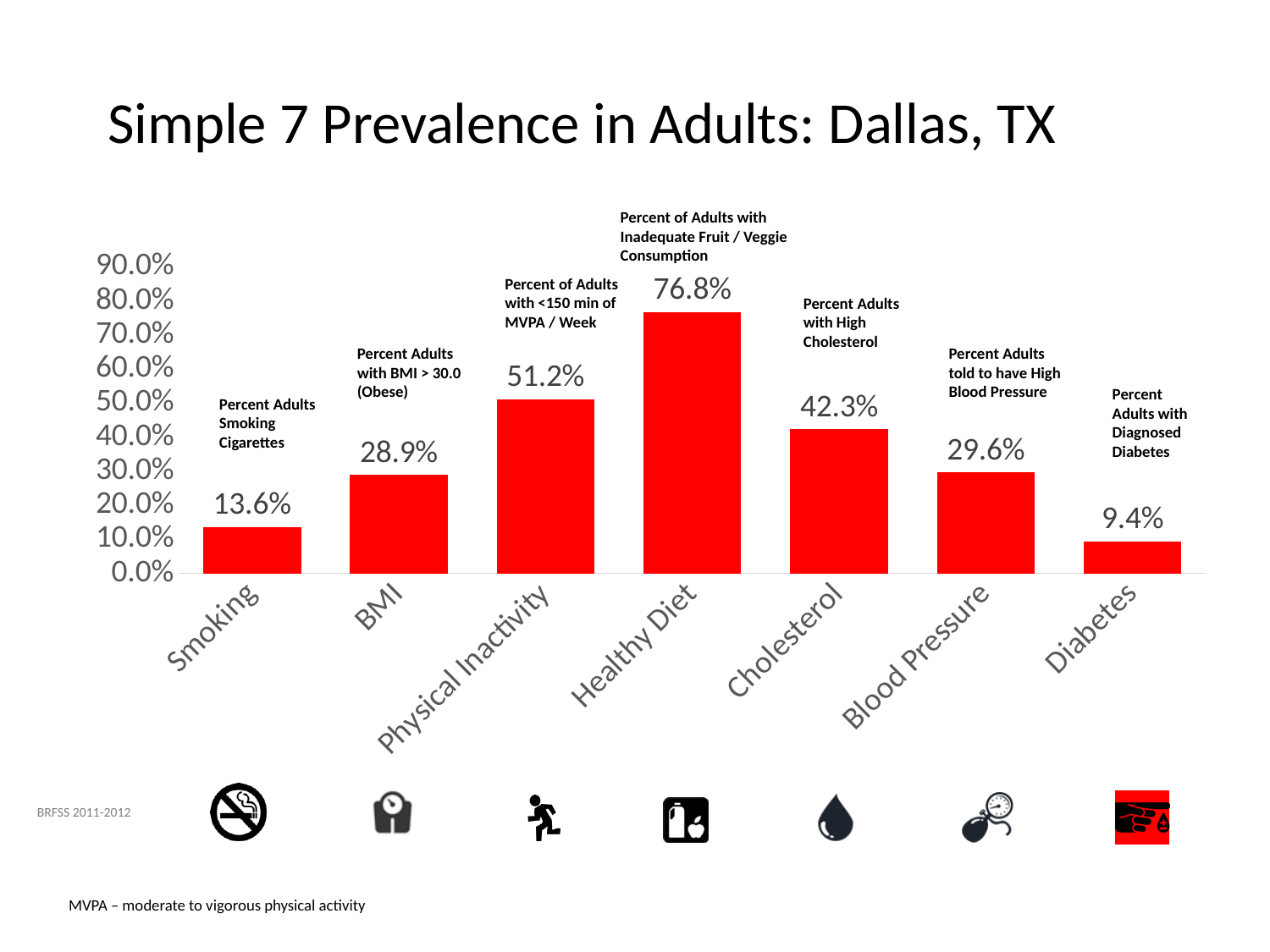
What is the difference between the values for BMI and Diabetes? 19.5% What is the title of the slide? Simple 7 Prevalence in Adults: Dallas, TX What is the difference between the values for Physical Inactivity and Cholesterol? 8.9% What is the value for Blood Pressure? 29.6% What is the value for Smoking? 13.6% How many categories are shown on the x axis? 7 What kind of chart is shown on the slide? bar chart Is the value for Cholesterol greater or less than 40.0%? greater What is the value for Healthy Diet? 76.8% Which category has the highest value? Healthy Diet Which is larger, the value for BMI or the value for Blood Pressure? Blood Pressure Which category has the lowest value? Diabetes